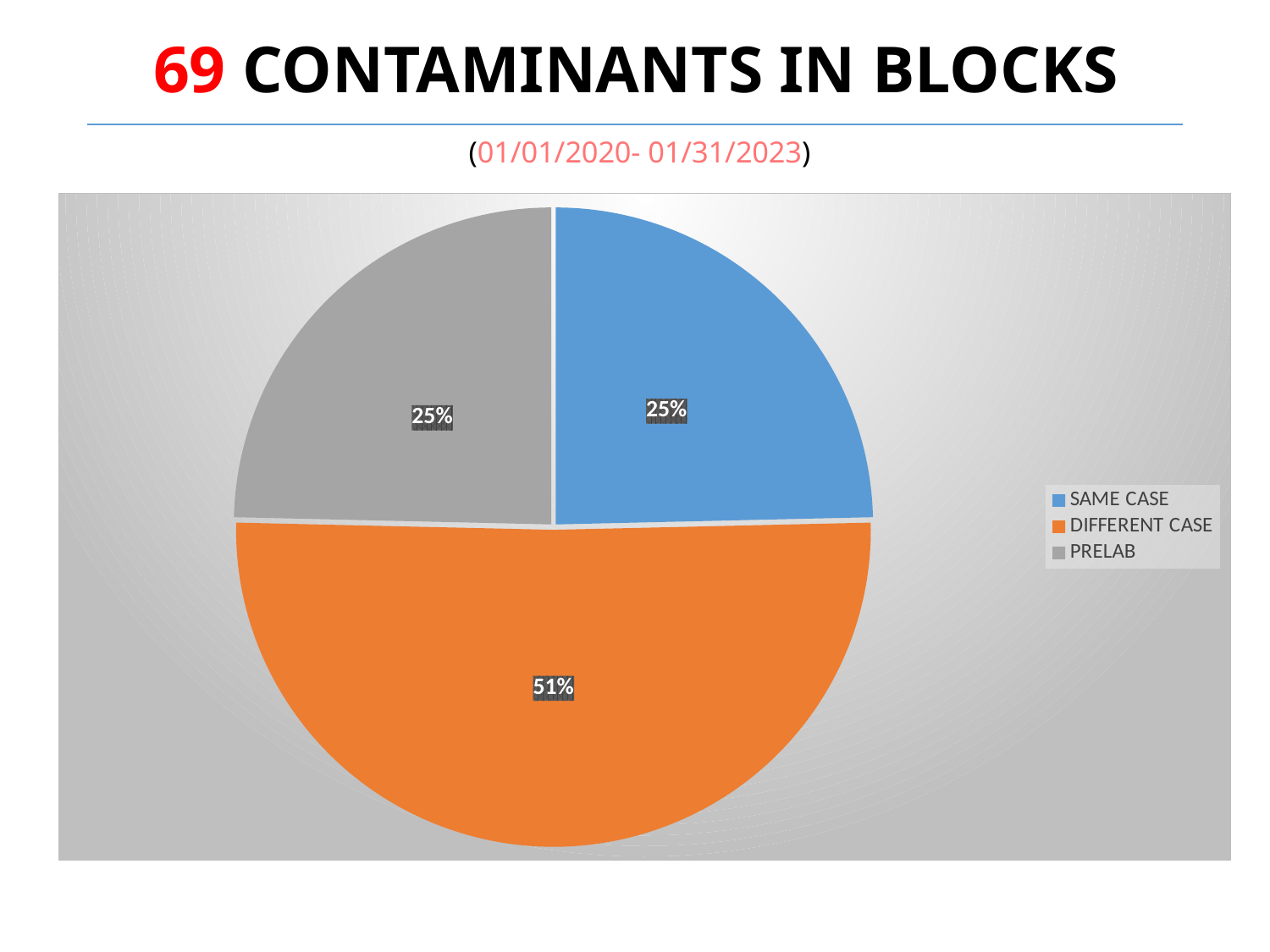
What date range is shown under the slide title? 01/01/2020- 01/31/2023 What kind of chart is shown on the slide? pie chart What share of the pie does DIFFERENT CASE represent? 51% How many categories does the legend list? 3 What colour is the DIFFERENT CASE slice? orange What share of the pie does PRELAB represent? 25% Which category has the largest slice of the pie? DIFFERENT CASE What share of the pie does SAME CASE represent? 25% What is the difference in percentage points between DIFFERENT CASE and SAME CASE? 26 Which is larger, the DIFFERENT CASE slice or the PRELAB slice? DIFFERENT CASE Is the share for DIFFERENT CASE greater or less than 50%? greater